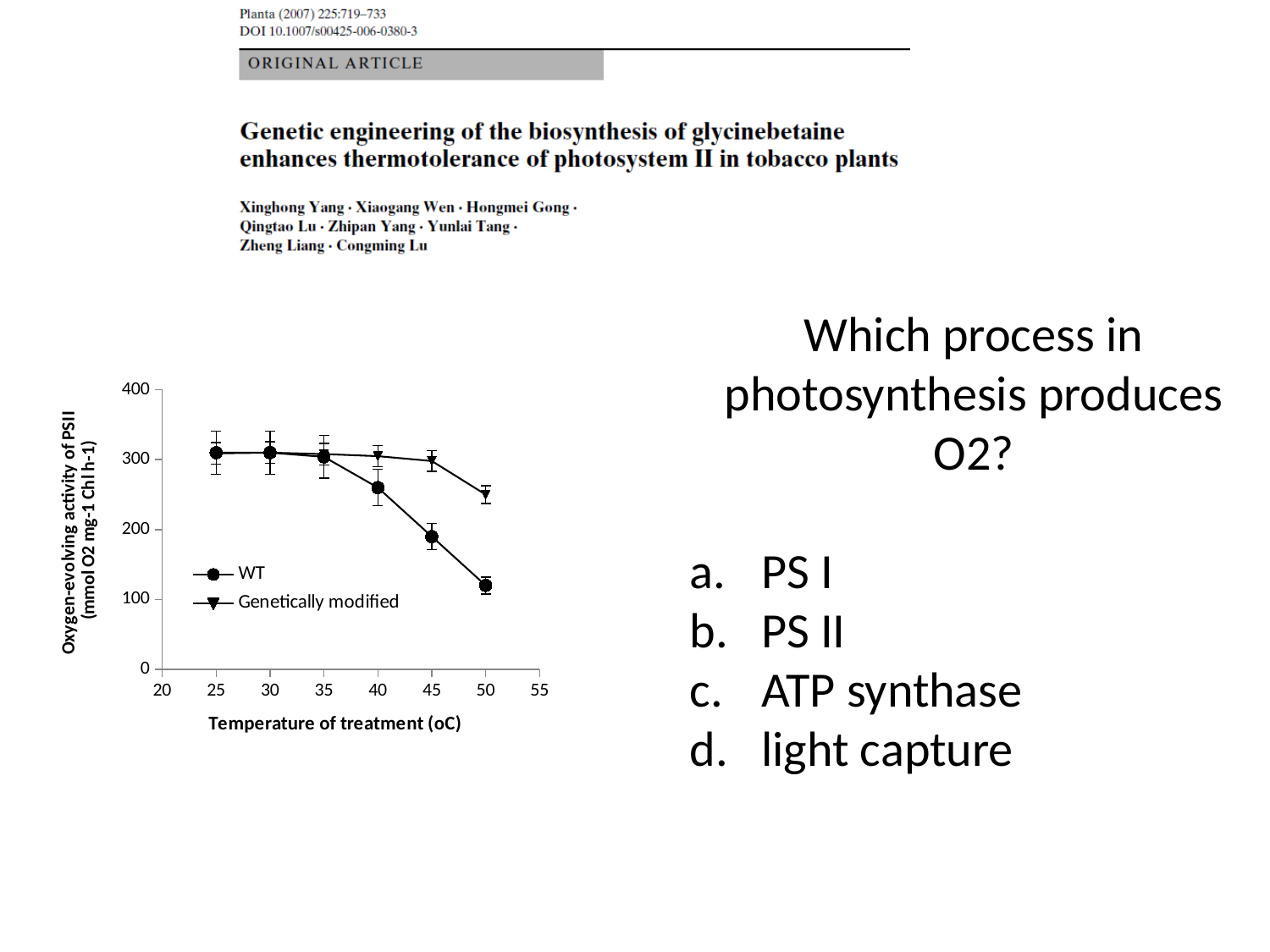
Does the WT series rise or fall as the temperature of treatment increases from 35 to 50 oC? fall At 50 oC, which series has the higher oxygen-evolving activity, WT or Genetically modified? Genetically modified Is the Genetically modified value at 50 oC greater or less than 200? greater Is the WT value at 50 oC greater or less than 200? less How many data points are plotted for the WT series? 6 At which temperature of treatment is the WT series lowest? 50 What kind of chart is shown on the slide? line chart How many series does the chart legend list? 2 What is the title of the x axis of the chart? Temperature of treatment (oC) Is the WT value at 50 oC greater or less than 100? greater What are the two series named in the chart legend? WT and Genetically modified